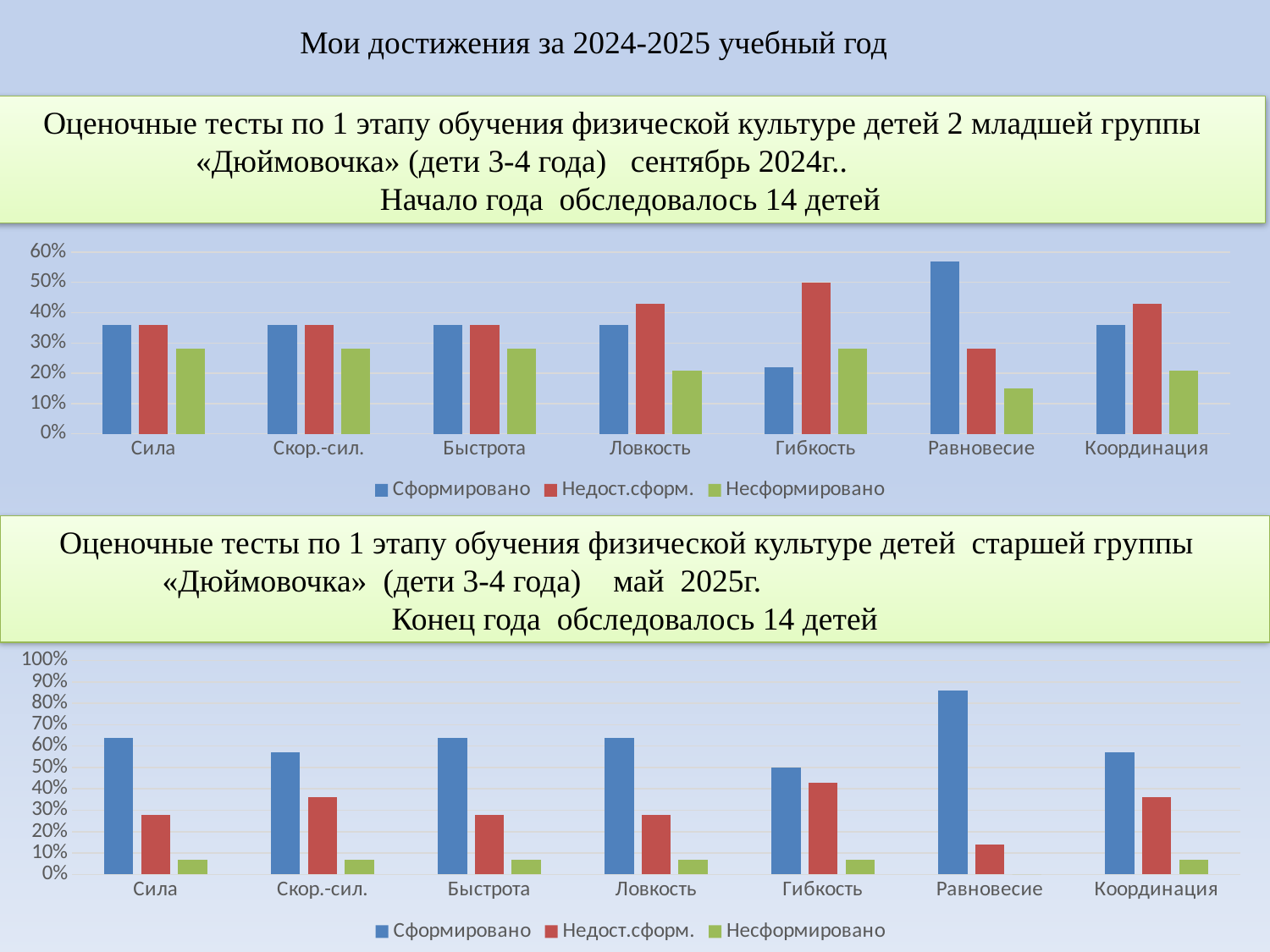
In the top chart (September 2024), is the Недост.сформ. value for Гибкость greater or less than 40%? greater In the bottom chart (May 2025), is the Сформировано value for Равновесие greater or less than 80%? greater In the bottom chart (May 2025), which category has the highest value for Сформировано? Равновесие What kind of chart is the top chart (September 2024)? bar chart In the bottom chart (May 2025), is the Недост.сформ. value for Равновесие greater or less than 20%? less In the top chart (September 2024), which category has the highest value for Сформировано? Равновесие How many series does the legend of the bottom chart (May 2025) list? 3 How many categories are shown on the x axis of the top chart (September 2024)? 7 In the top chart (September 2024), which category has the lowest value for Сформировано? Гибкость In the bottom chart (May 2025), for Гибкость, which is larger: Сформировано or Недост.сформ.? Сформировано In the bottom chart (May 2025), which colour represents the Сформировано series? blue